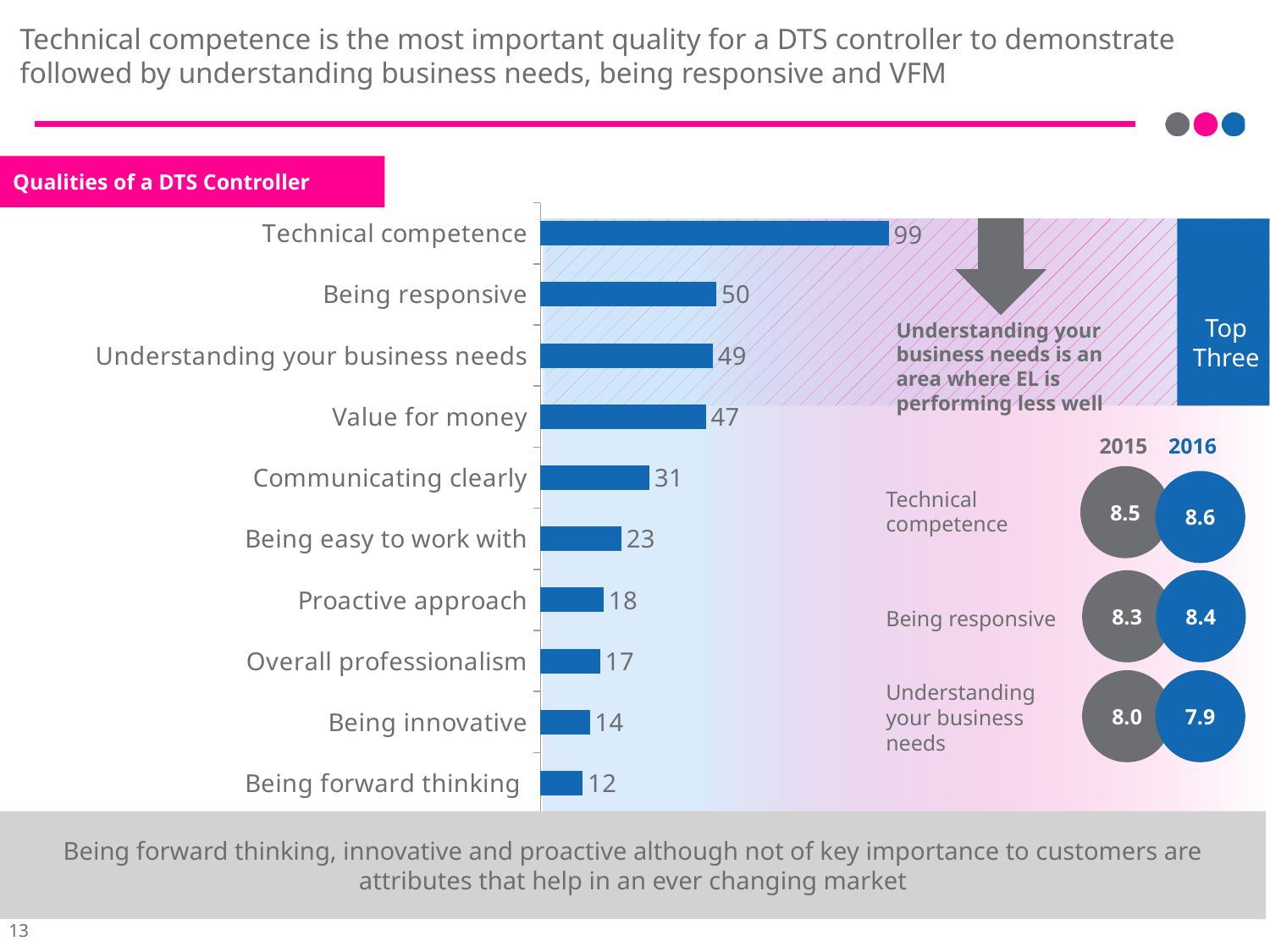
How many categories are shown in the bar chart? 10 What kind of chart is shown on the slide? Bar chart Which is larger, the value for Overall professionalism or the value for Being innovative? Overall professionalism What is the difference between the values for Technical competence and Being responsive? 49 Which category has the highest value? Technical competence What is the value for Technical competence? 99 What is the difference between the values for Communicating clearly and Proactive approach? 13 Which is larger, the value for Being responsive or the value for Understanding your business needs? Being responsive What is the value for Being easy to work with? 23 What is the value for Value for money? 47 What is the title shown above the chart? Qualities of a DTS Controller Which category has the lowest value? Being forward thinking